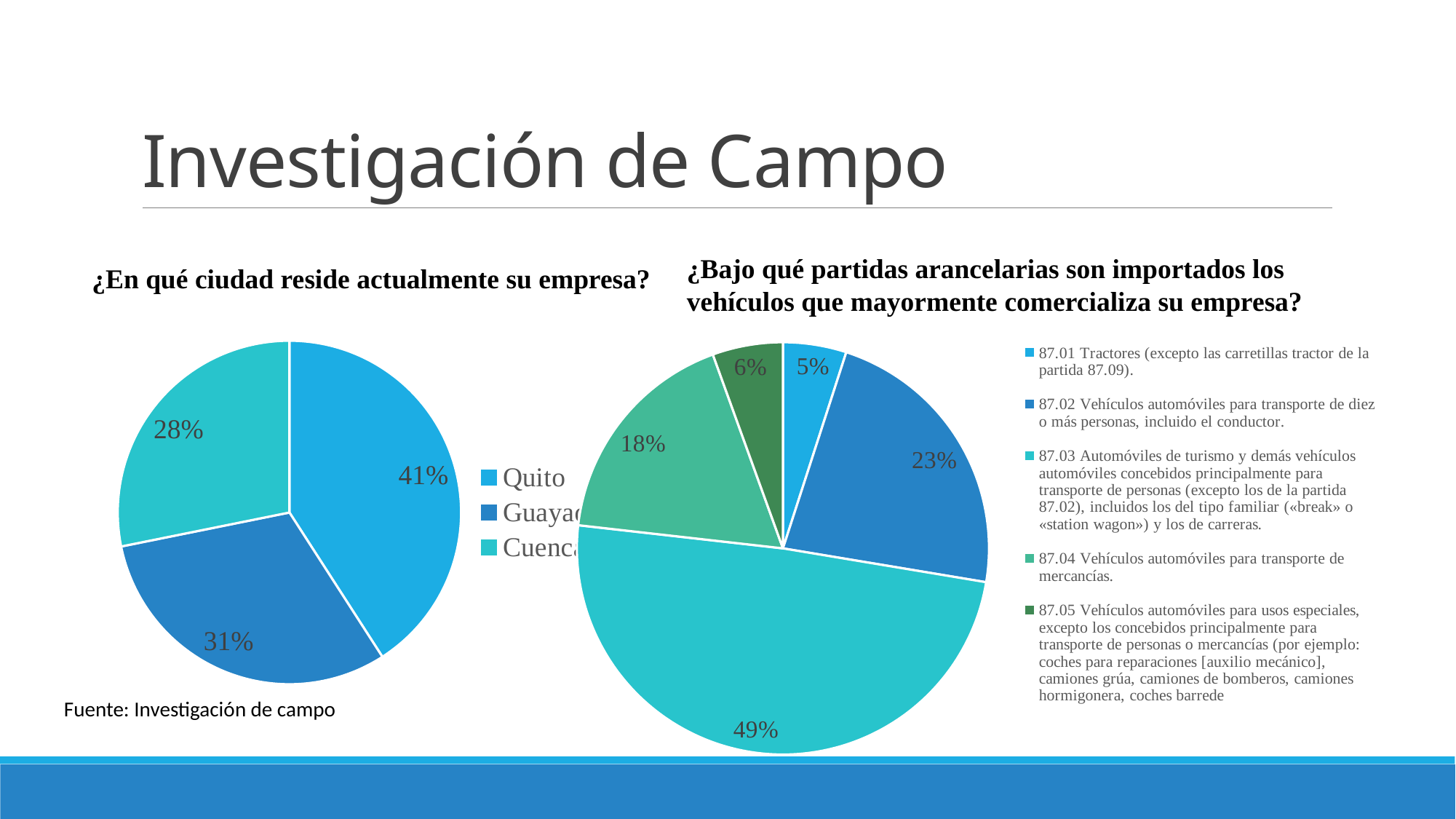
On the right chart (partidas arancelarias), what share corresponds to 87.03 Automóviles de turismo? 49% On the right chart (partidas arancelarias), which has a larger share: 87.05 Vehículos para usos especiales or 87.01 Tractores? 87.05 Vehículos para usos especiales On the right chart (partidas arancelarias), what is the difference between the shares of 87.02 and 87.04? 5% On the left chart (¿En qué ciudad reside actualmente su empresa?), what is the difference between the largest slice (41%) and the smallest slice (28%)? 13% On the right chart (partidas arancelarias), what share corresponds to 87.01 Tractores? 5% On the right chart (partidas arancelarias), how many tariff headings does the legend list? 5 On the left chart (¿En qué ciudad reside actualmente su empresa?), which city has the largest share? Quito What kind of chart is used for the question ¿Bajo qué partidas arancelarias son importados los vehículos que mayormente comercializa su empresa? Pie chart On the right chart (partidas arancelarias), which tariff heading has the smallest share? 87.01 Tractores On the left chart (¿En qué ciudad reside actualmente su empresa?), how many slices does the pie have? 3 On the left chart (¿En qué ciudad reside actualmente su empresa?), what share of companies reside in Quito? 41% On the right chart (partidas arancelarias), which tariff heading has the largest share? 87.03 Automóviles de turismo